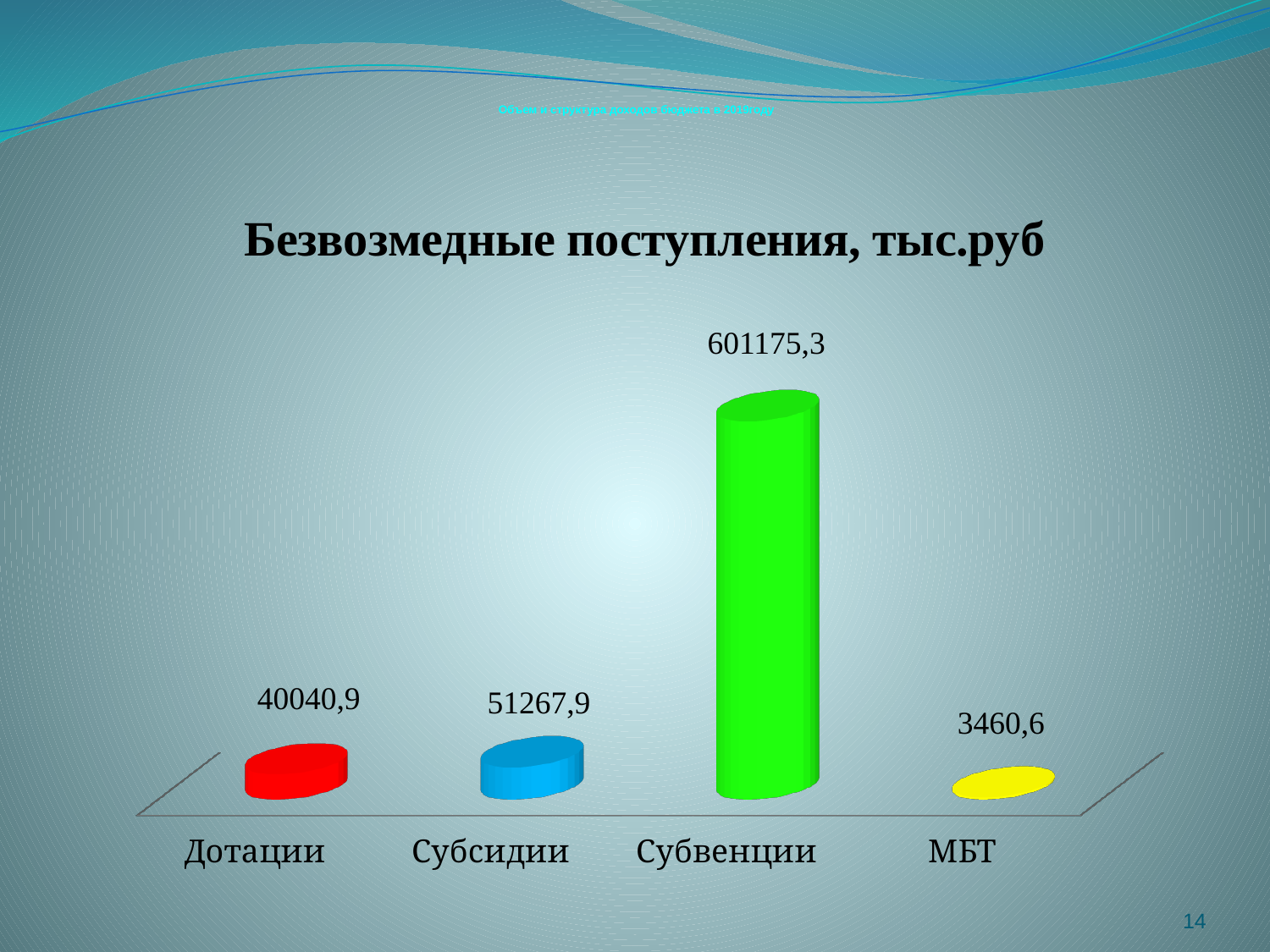
Which category has the lowest value? МБТ How many categories are shown in the chart? 4 What kind of chart is shown on the slide? Bar chart What is the value for Субвенции? 601175,3 What is the difference between the values for Субсидии and Дотации? 11227,0 Which is larger, the value for Субсидии or the value for Дотации? Субсидии What is the value for Дотации? 40040,9 Which category has the highest value? Субвенции What is the value for Субсидии? 51267,9 What is the difference between the values for Дотации and МБТ? 36580,3 What is the title of the chart? Безвозмедные поступления, тыс.руб What is the value for МБТ? 3460,6